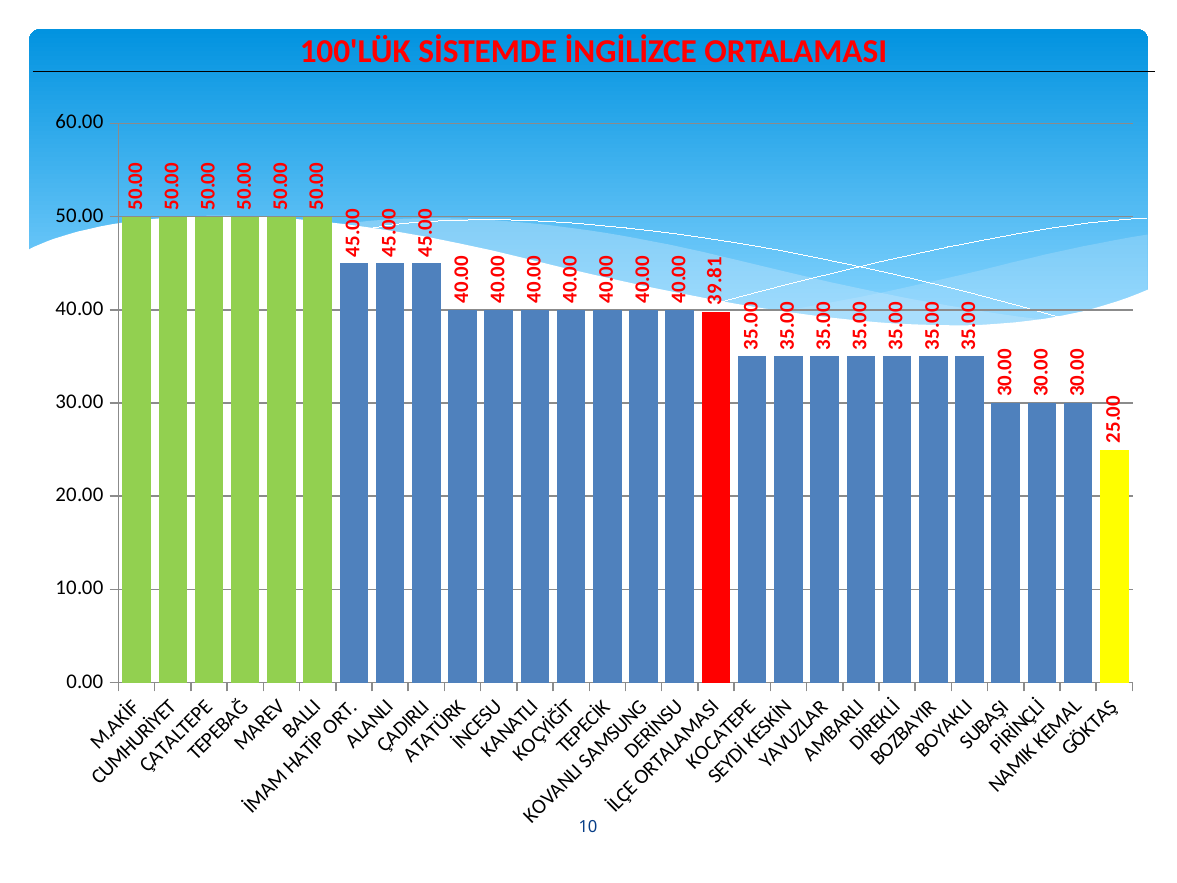
What is the title of the chart? 100'LÜK SİSTEMDE İNGİLİZCE ORTALAMASI What is the value for GÖKTAŞ? 25.00 Is the value for SUBAŞI greater or less than 40.00? less What is the value for İLÇE ORTALAMASI? 39.81 How many categories are shown on the x axis? 28 What is the value for ALANLI? 45.00 What is the difference between the values for M.AKİF and GÖKTAŞ? 25.00 Which is larger, the value for KOCATEPE or the value for ÇADIRLI? ÇADIRLI What kind of chart is shown on the slide? bar chart Which category has the lowest value? GÖKTAŞ What is the difference between the values for ATATÜRK and İLÇE ORTALAMASI? 0.19 What is the value for NAMIK KEMAL? 30.00